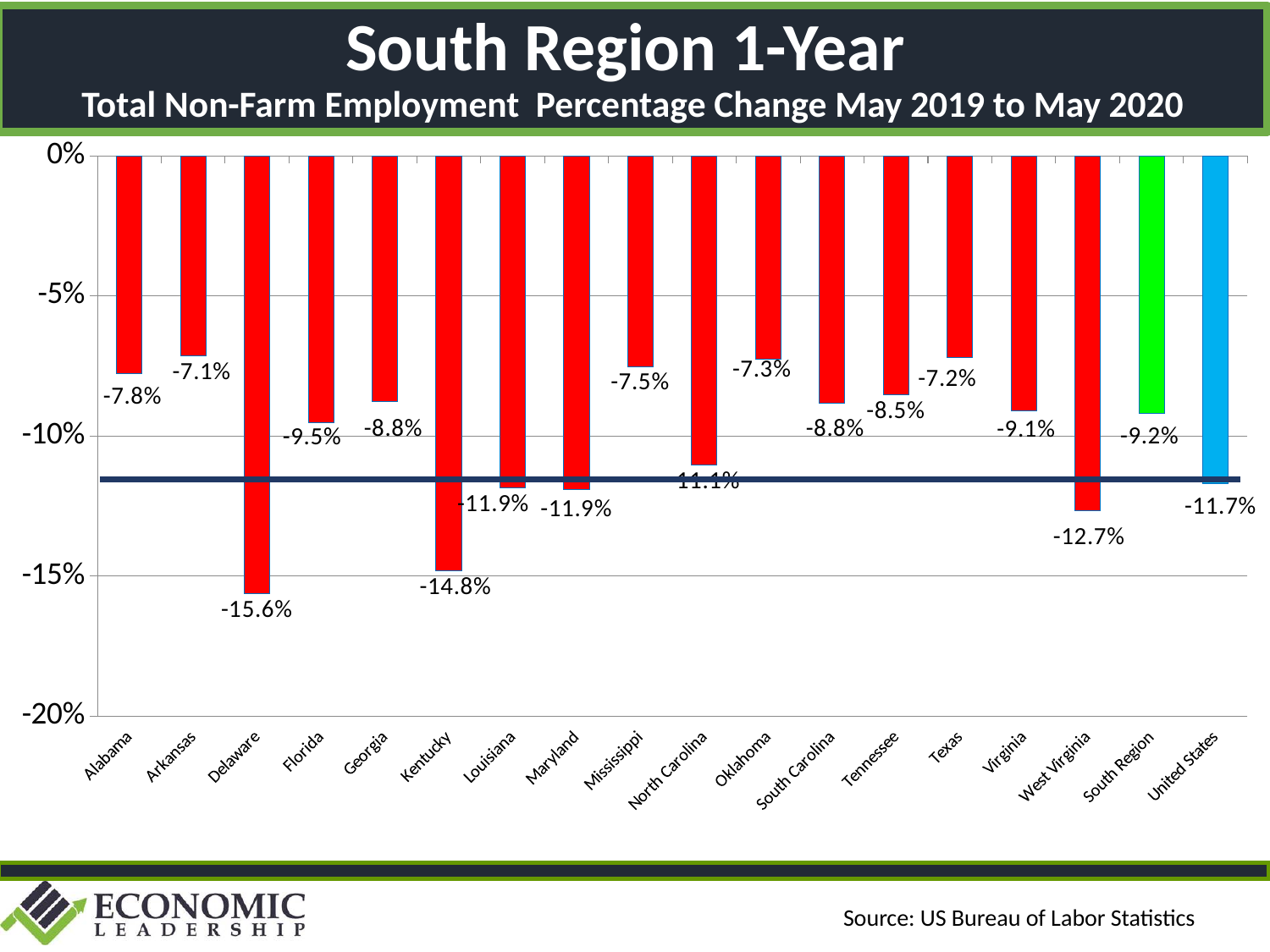
Which has a larger decline, West Virginia or North Carolina? West Virginia Which category has the lowest (most negative) value? Delaware What is the value for the United States? -11.7% How many categories are shown on the x axis? 18 What is the difference between the values for Delaware and Kentucky? 0.8 percentage points Which category has the highest (least negative) value? Arkansas What is the value for Kentucky? -14.8% What is the value for the South Region? -9.2% What colour is the bar for the South Region? Green What kind of chart is shown on the slide? Bar chart What is the value for Texas? -7.2% What is the value for Delaware? -15.6%